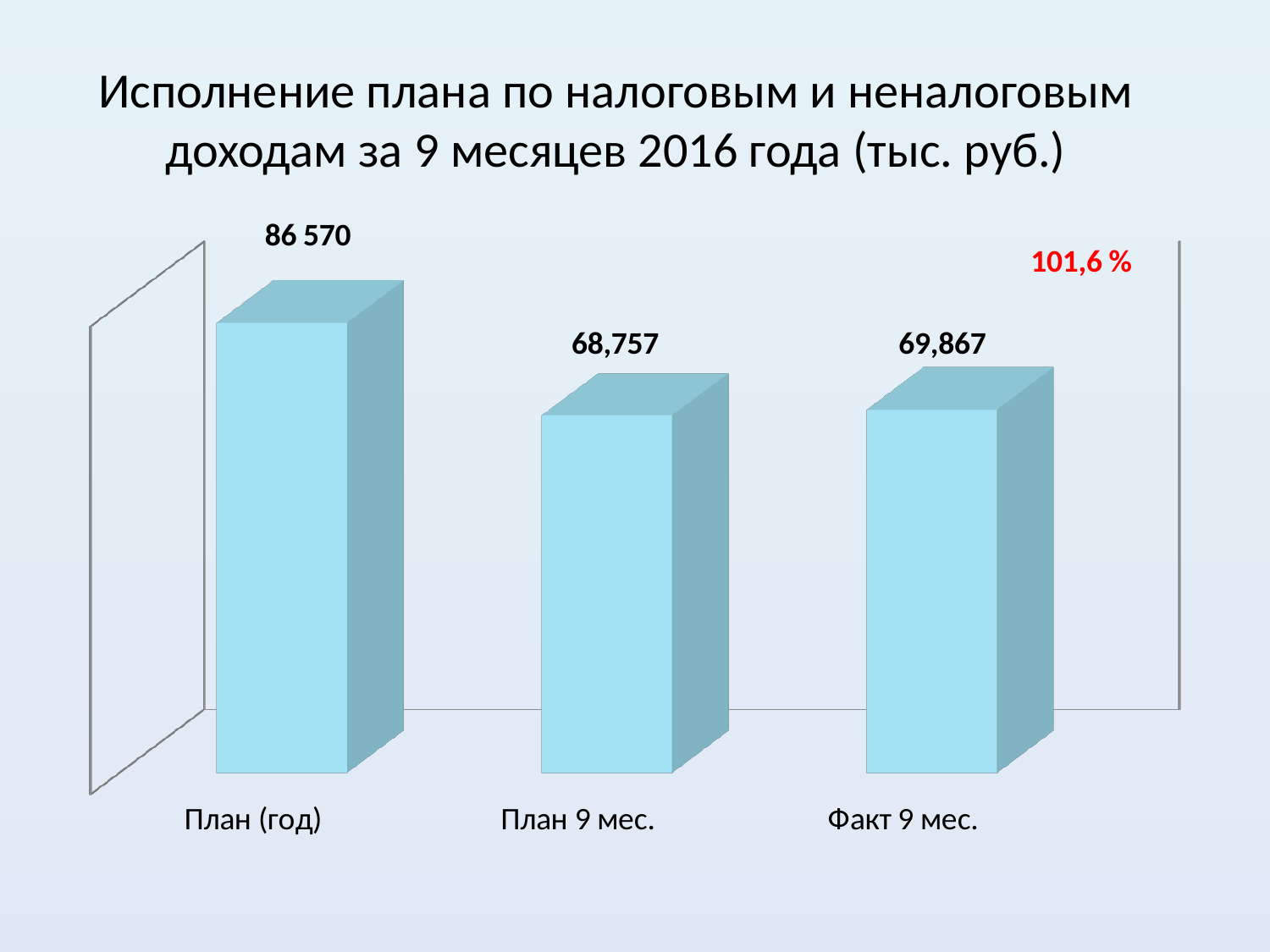
Which category has the lowest value? План 9 мес. What kind of chart is shown on the slide? Bar chart Which category has the highest value? План (год) How many bars are shown in the chart? 3 What is the value for План 9 мес.? 68,757 What percentage is shown in red on the chart? 101,6 % What unit of measurement is given in the chart title? тыс. руб. Which is larger, the value for Факт 9 мес. or the value for План 9 мес.? Факт 9 мес. What is the value for План (год)? 86 570 What is the value for Факт 9 мес.? 69,867 What is the difference between the values for Факт 9 мес. and План 9 мес.? 1,110